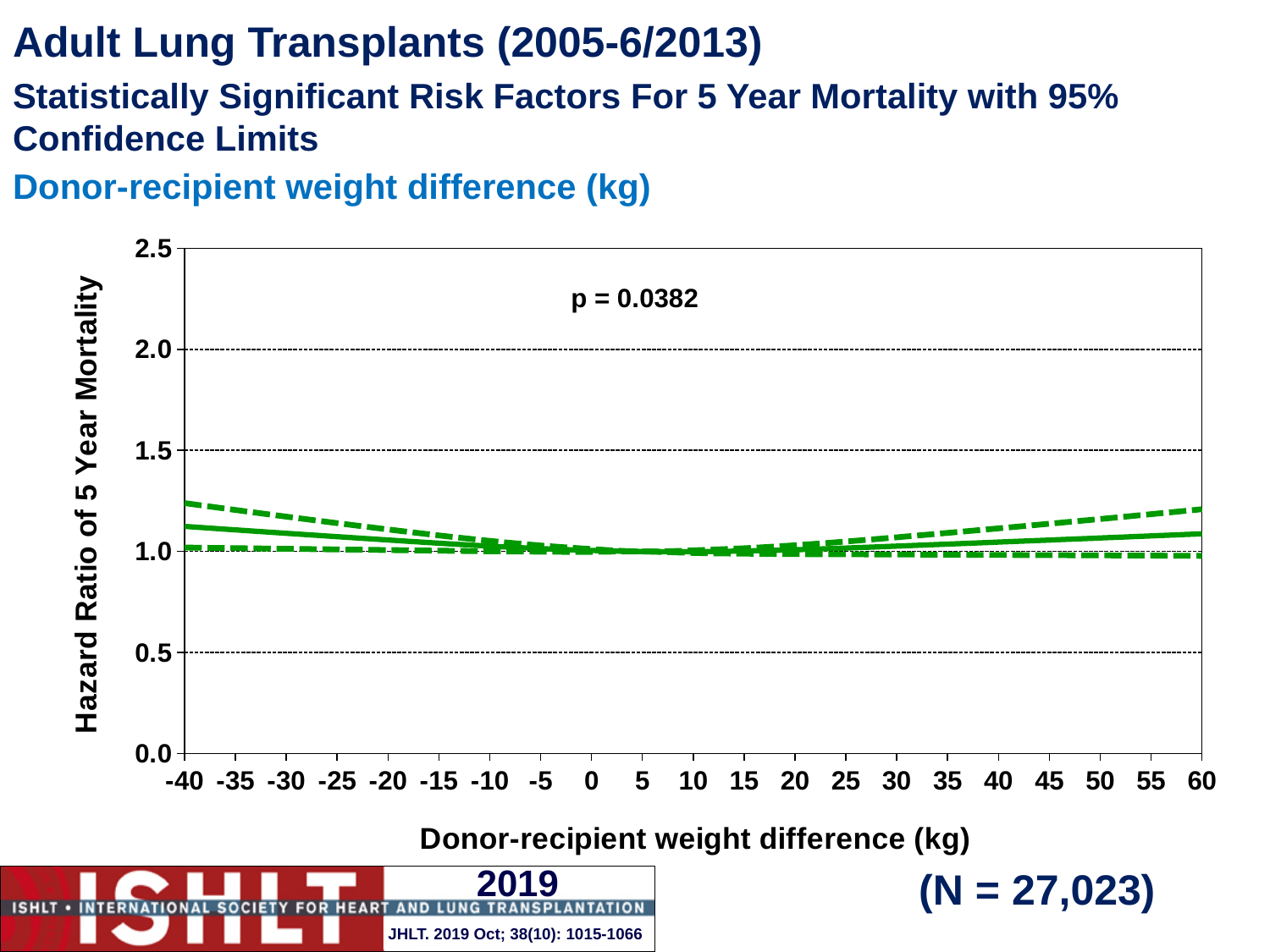
Does the solid line rise or fall as the donor-recipient weight difference increases from 10 kg to 60 kg? rise Is the value of the solid line at -40 kg larger or smaller than its value at 60 kg? larger What is the sample size (N) shown on the slide? N = 27,023 What is the p-value printed on the chart? p = 0.0382 Is the value of the solid line at a donor-recipient weight difference of -40 kg greater or less than 1.0? greater How many lines are plotted on the chart? 3 What is the highest value shown on the y axis? 2.5 Is the value of the upper dashed line at a donor-recipient weight difference of -40 kg greater or less than 1.5? less Is the value of the solid line at a donor-recipient weight difference of 60 kg greater or less than 1.5? less Does the solid line rise or fall as the donor-recipient weight difference increases from -40 kg to 5 kg? fall What kind of chart is shown on the slide? Line chart